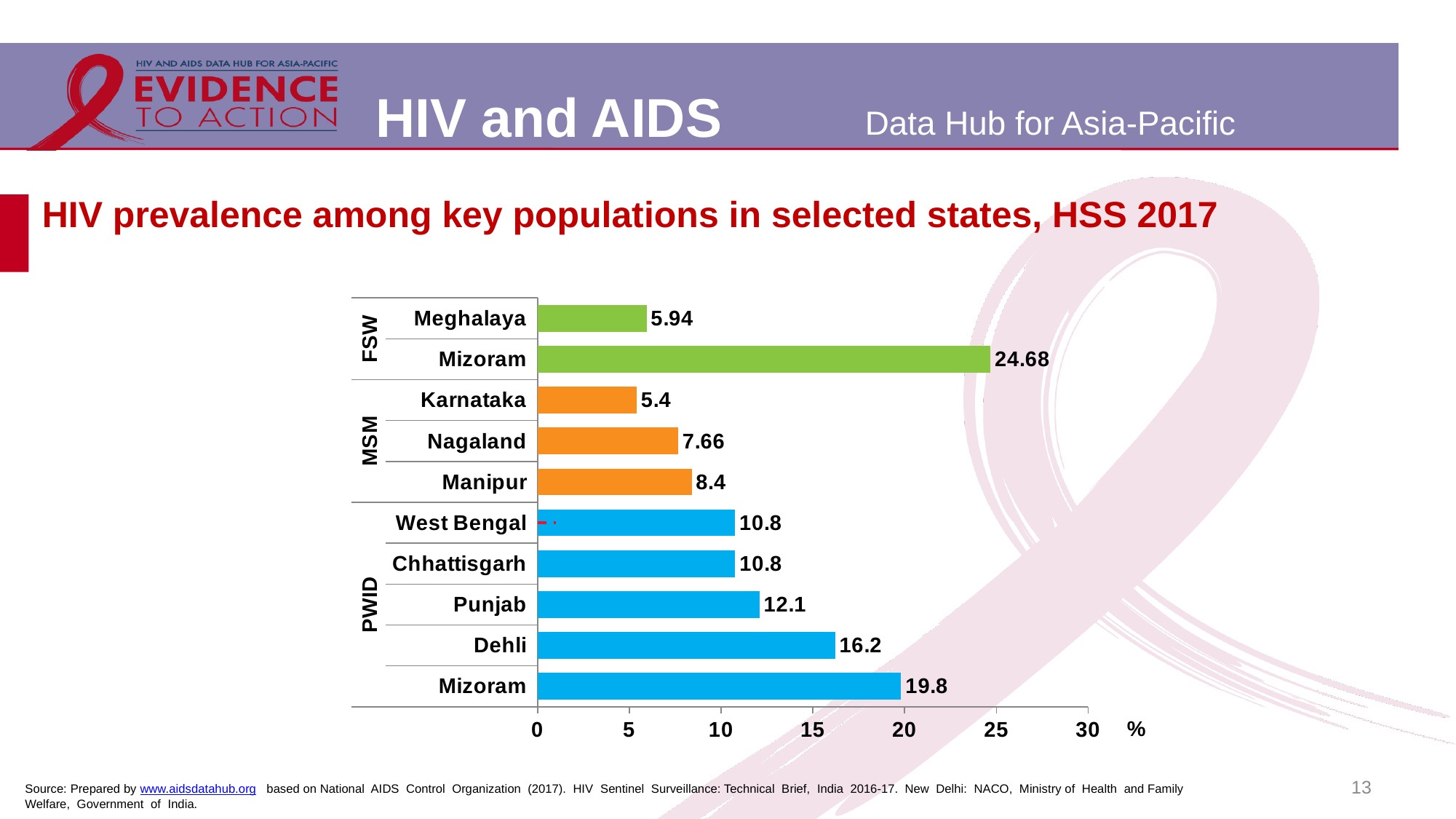
What is the HIV prevalence among PWID in Dehli? 16.2 What is the HIV prevalence among PWID in Punjab? 12.1 What is the difference between the HIV prevalence among FSW in Mizoram and among FSW in Meghalaya? 18.74 Which is larger, the HIV prevalence among MSM in Manipur or among MSM in Karnataka? Manipur Which state has the highest HIV prevalence value on the chart? Mizoram (FSW) Is the HIV prevalence among PWID in Mizoram greater or less than 15? greater What type of chart is shown on the slide? Bar chart What is the difference between the HIV prevalence among PWID in Mizoram and among PWID in Dehli? 3.6 What is the HIV prevalence among FSW in Mizoram? 24.68 What is the HIV prevalence among MSM in Nagaland? 7.66 Which state has the lowest HIV prevalence value on the chart? Karnataka How many bars are plotted on the chart? 10